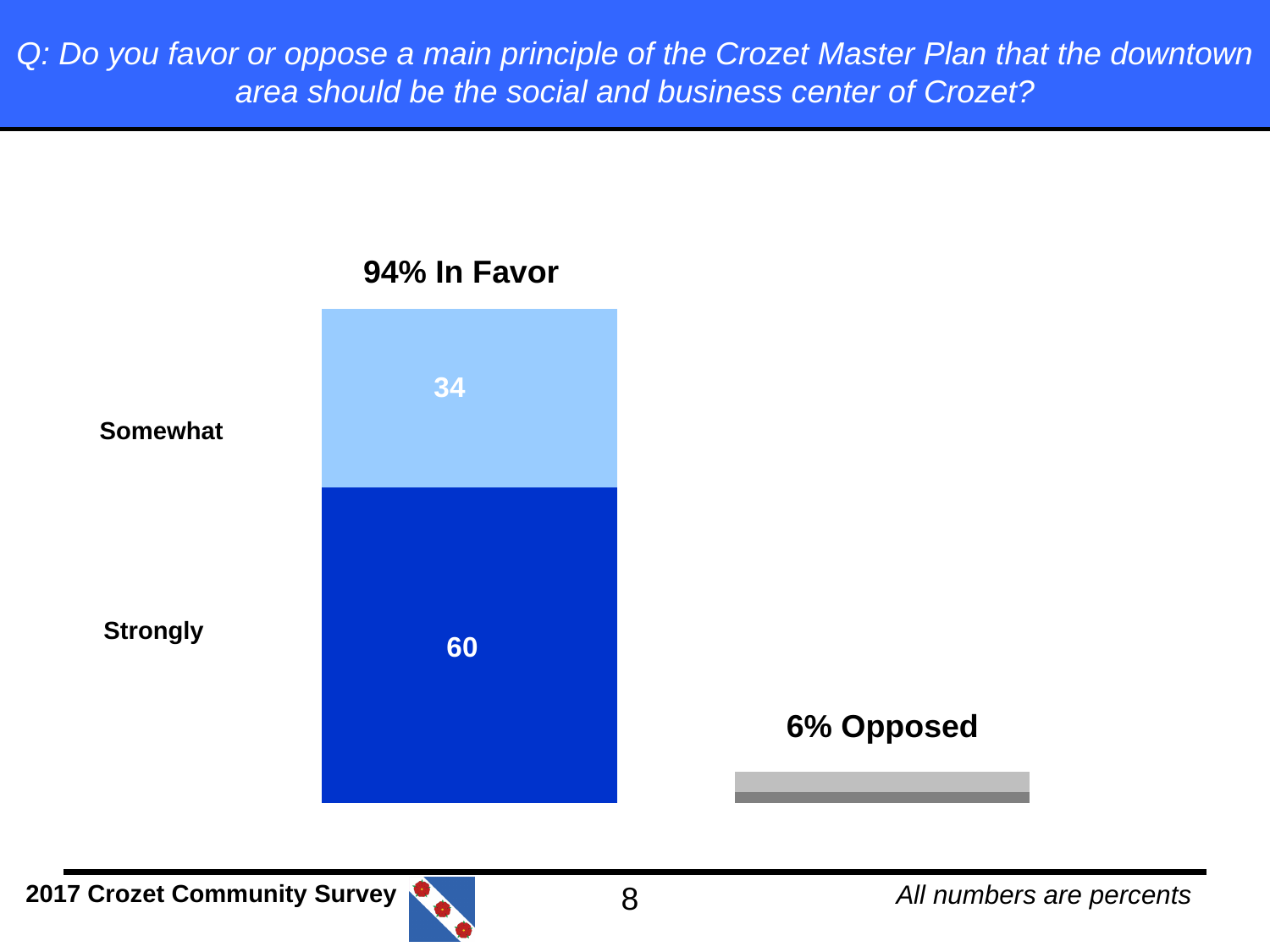
What colour is the Strongly segment of the In Favor bar? Dark blue How many labelled segments make up the In Favor bar? 2 What percentage of respondents are Opposed? 6% What is the difference between the In Favor total and the Opposed total? 88% What is the value for the Somewhat segment of the In Favor bar? 34 What is the total of the In Favor stacked bar? 94% What is the difference between the Strongly and Somewhat values in the In Favor bar? 26 What is the value for the Strongly segment of the In Favor bar? 60 What kind of chart is shown on the slide? Bar chart Which segment of the In Favor bar is larger, Strongly or Somewhat? Strongly Which segment of the In Favor bar has the smallest value? Somewhat Which is larger, the In Favor total or the Opposed total? In Favor